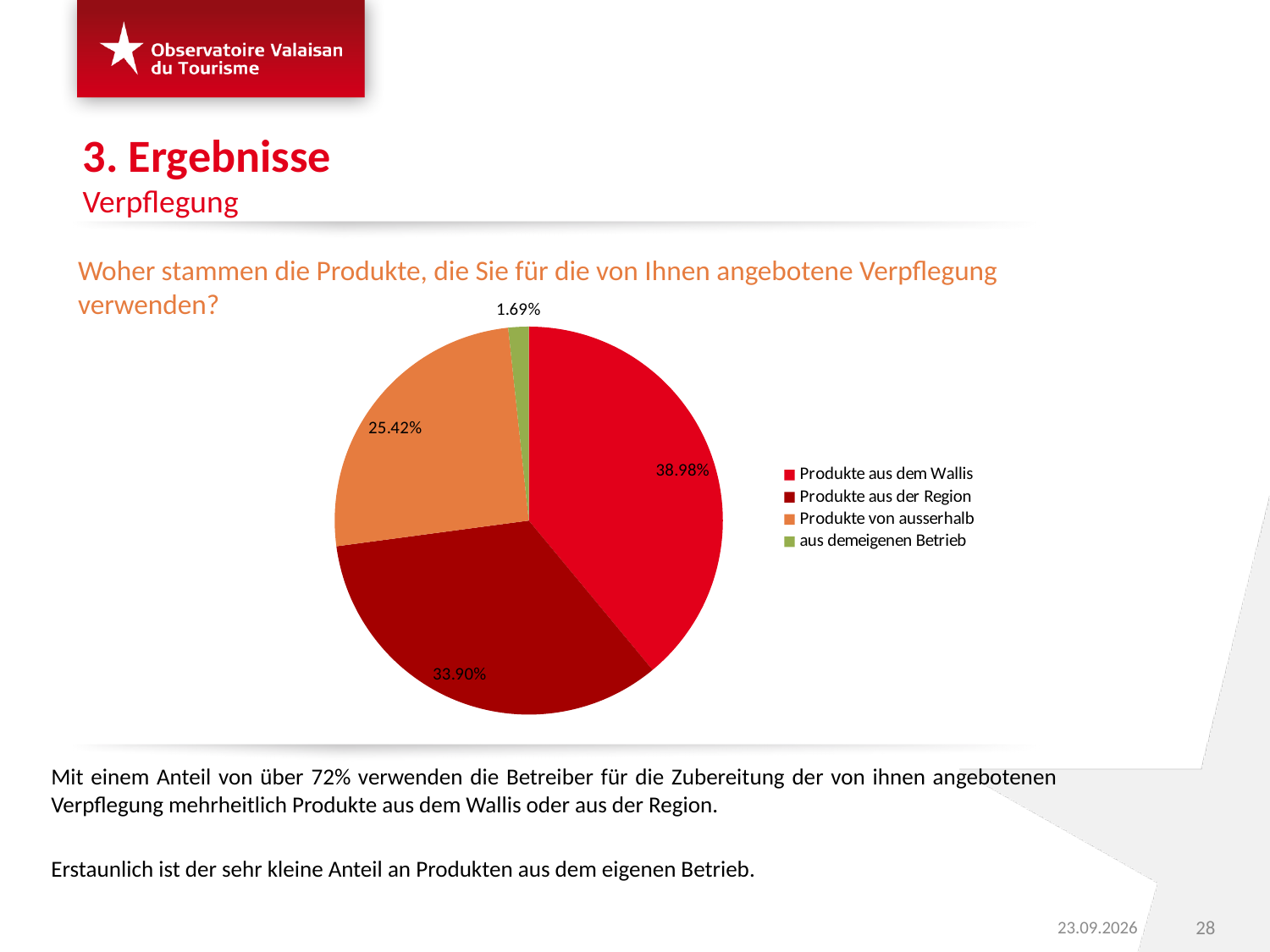
Which category has the largest slice of the pie? Produkte aus dem Wallis What share of the pie is labelled for 'Produkte aus dem Wallis'? 38.98% How many slices does the pie chart have? 4 What share of the pie is labelled for 'Produkte von ausserhalb'? 25.42% What is the difference in percentage points between 'Produkte aus dem Wallis' and 'Produkte aus der Region'? 5.08 What colour is the slice for 'Produkte von ausserhalb'? orange How many entries does the legend list? 4 What kind of chart is shown on the slide? pie chart What share of the pie is labelled for 'aus demeigenen Betrieb'? 1.69% What share of the pie is labelled for 'Produkte aus der Region'? 33.90% Which is larger: the slice for 'Produkte von ausserhalb' or the slice for 'Produkte aus der Region'? Produkte aus der Region Which category has the smallest slice of the pie? aus demeigenen Betrieb